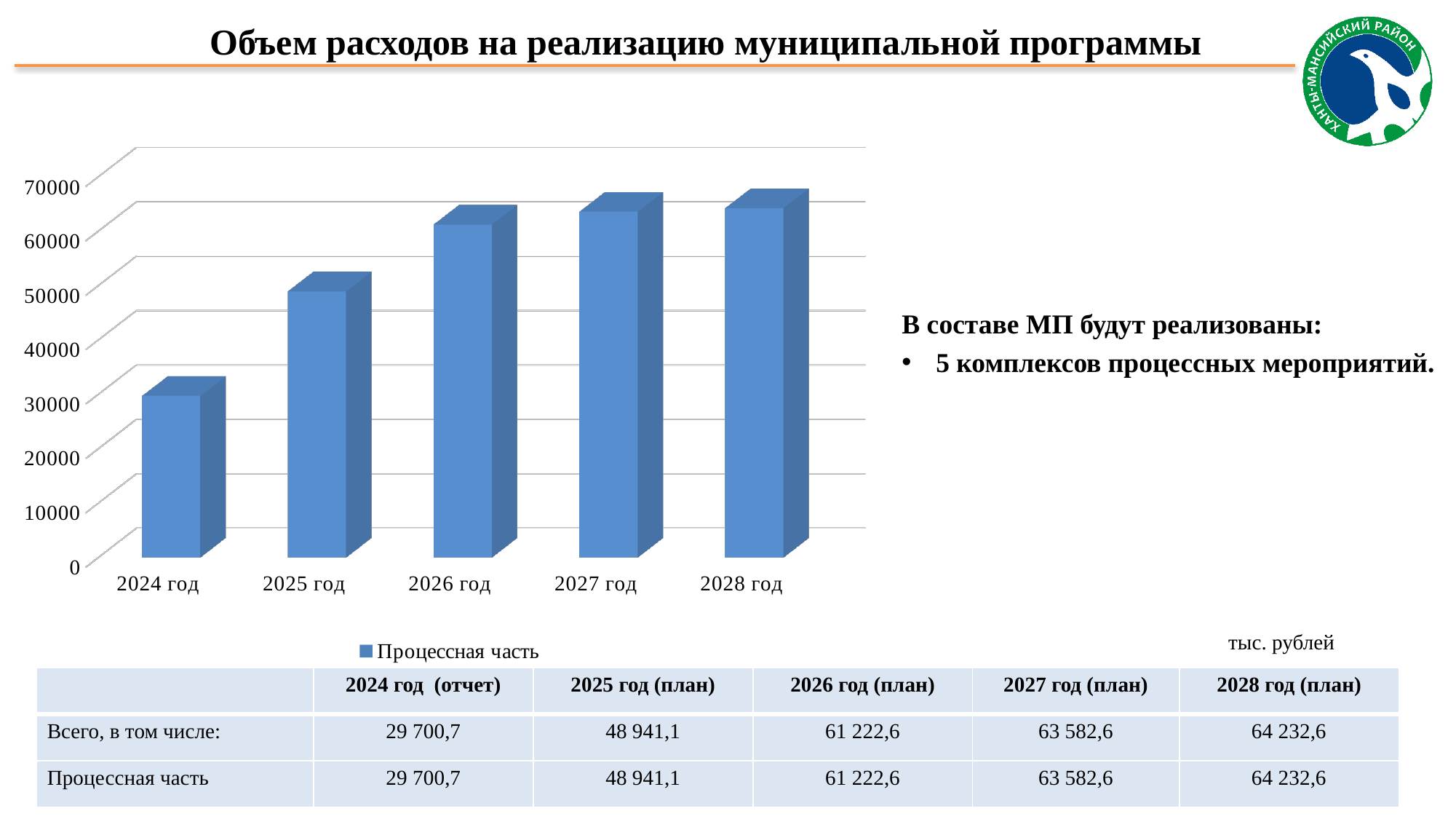
Which year has the highest value on the chart? 2028 год What is the value of Процессная часть for 2026 год, as given in the table? 61 222,6 Do the values rise or fall from 2024 год to 2028 год? rise Is the value for 2024 год greater or less than 40000? less How many years (categories) are plotted on the chart? 5 Which year has the lowest value on the chart? 2024 год Is the value for 2026 год greater or less than 60000? greater What kind of chart is shown on the slide? Bar chart Using the table values, what is the difference between 2025 год and 2024 год? 19 240,4 How many series does the chart legend list? 1 What is the value of Процессная часть for 2024 год, as given in the table? 29 700,7 What is the name of the series shown in the chart legend? Процессная часть